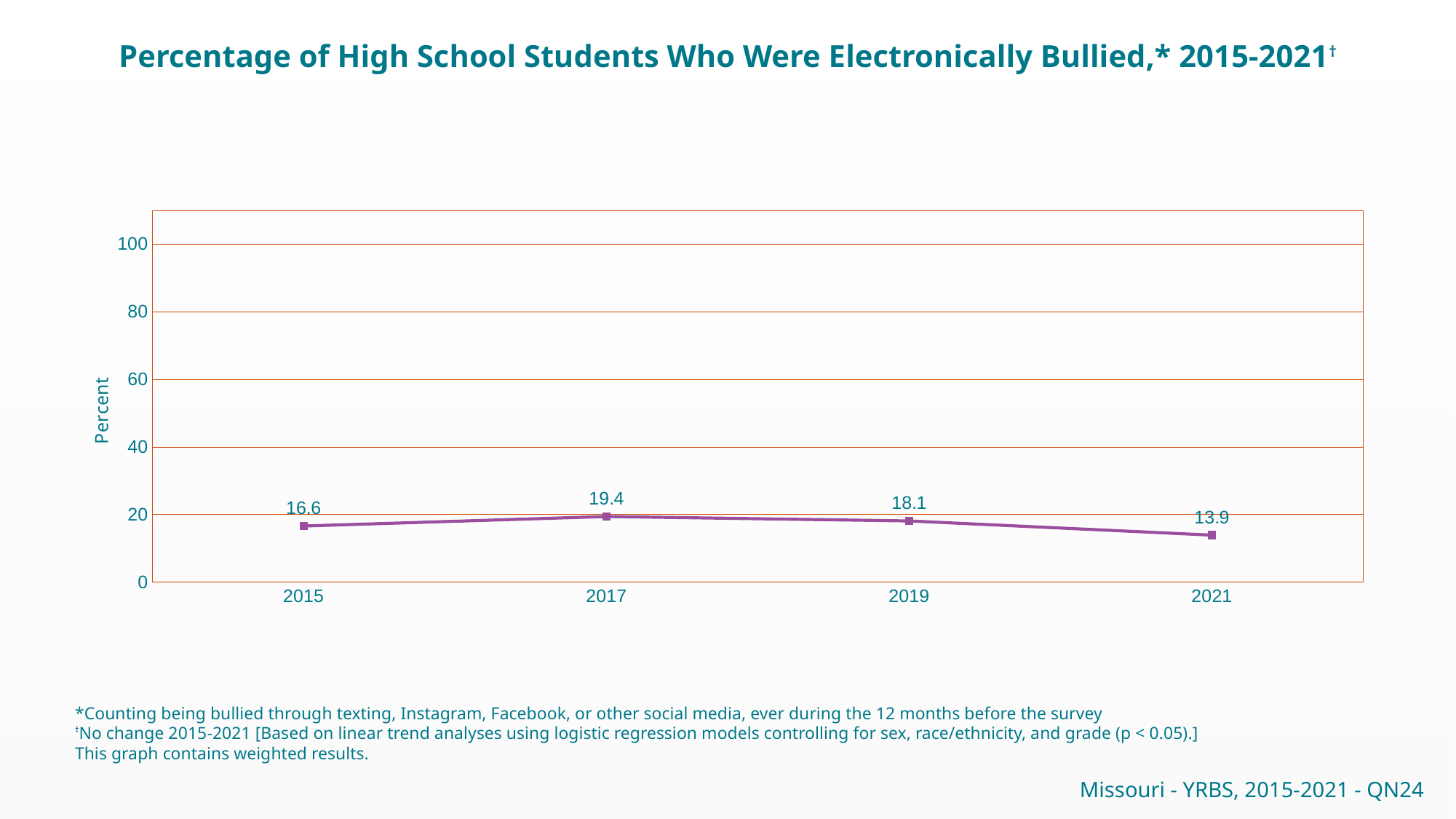
What kind of chart is shown on the slide? line chart What was the percentage of high school students who were electronically bullied in 2017? 19.4 What was the percentage of high school students who were electronically bullied in 2015? 16.6 How many years are plotted on the chart? 4 In which year was the percentage of students electronically bullied lowest? 2021 What was the percentage of high school students who were electronically bullied in 2019? 18.1 What is the difference between the 2017 and 2021 values? 5.5 In which year was the percentage of students electronically bullied highest? 2017 Is the value for 2021 greater or less than 20? less What was the percentage of high school students who were electronically bullied in 2021? 13.9 Which year had a higher value, 2015 or 2019? 2019 What is the label on the vertical axis? Percent